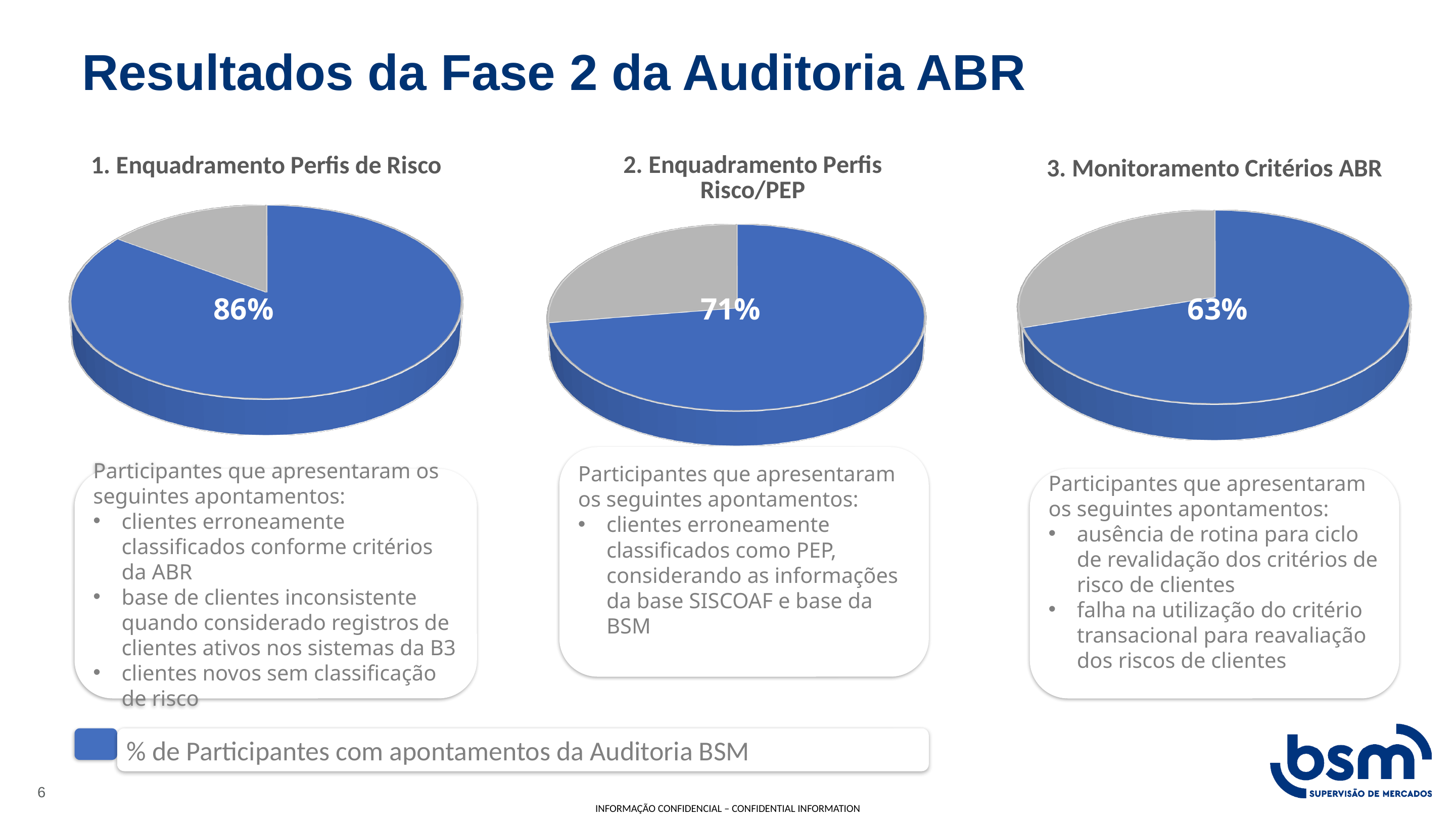
In the chart titled "2. Enquadramento Perfis Risco/PEP", how many slices does the pie have? 2 According to the legend at the bottom of the slide, what does the blue colour in the pie charts represent? % de Participantes com apontamentos da Auditoria BSM In the chart titled "1. Enquadramento Perfis de Risco", what percentage is shown on the blue slice? 86% What is the difference between the percentage in the chart "1. Enquadramento Perfis de Risco" and the percentage in the chart "2. Enquadramento Perfis Risco/PEP"? 15% What type of chart is used for "3. Monitoramento Critérios ABR"? Pie chart What is the difference between the percentage in the chart "2. Enquadramento Perfis Risco/PEP" and the percentage in the chart "3. Monitoramento Critérios ABR"? 8% In the chart titled "3. Monitoramento Critérios ABR", what percentage is shown on the blue slice? 63% How many pie charts are shown on the slide? 3 In the chart titled "2. Enquadramento Perfis Risco/PEP", what percentage is shown on the blue slice? 71% Which is larger: the percentage in the chart "1. Enquadramento Perfis de Risco" or the percentage in the chart "3. Monitoramento Critérios ABR"? 1. Enquadramento Perfis de Risco Which of the three charts shows the highest percentage of participants with apontamentos? 1. Enquadramento Perfis de Risco Which of the three charts shows the lowest percentage of participants with apontamentos? 3. Monitoramento Critérios ABR